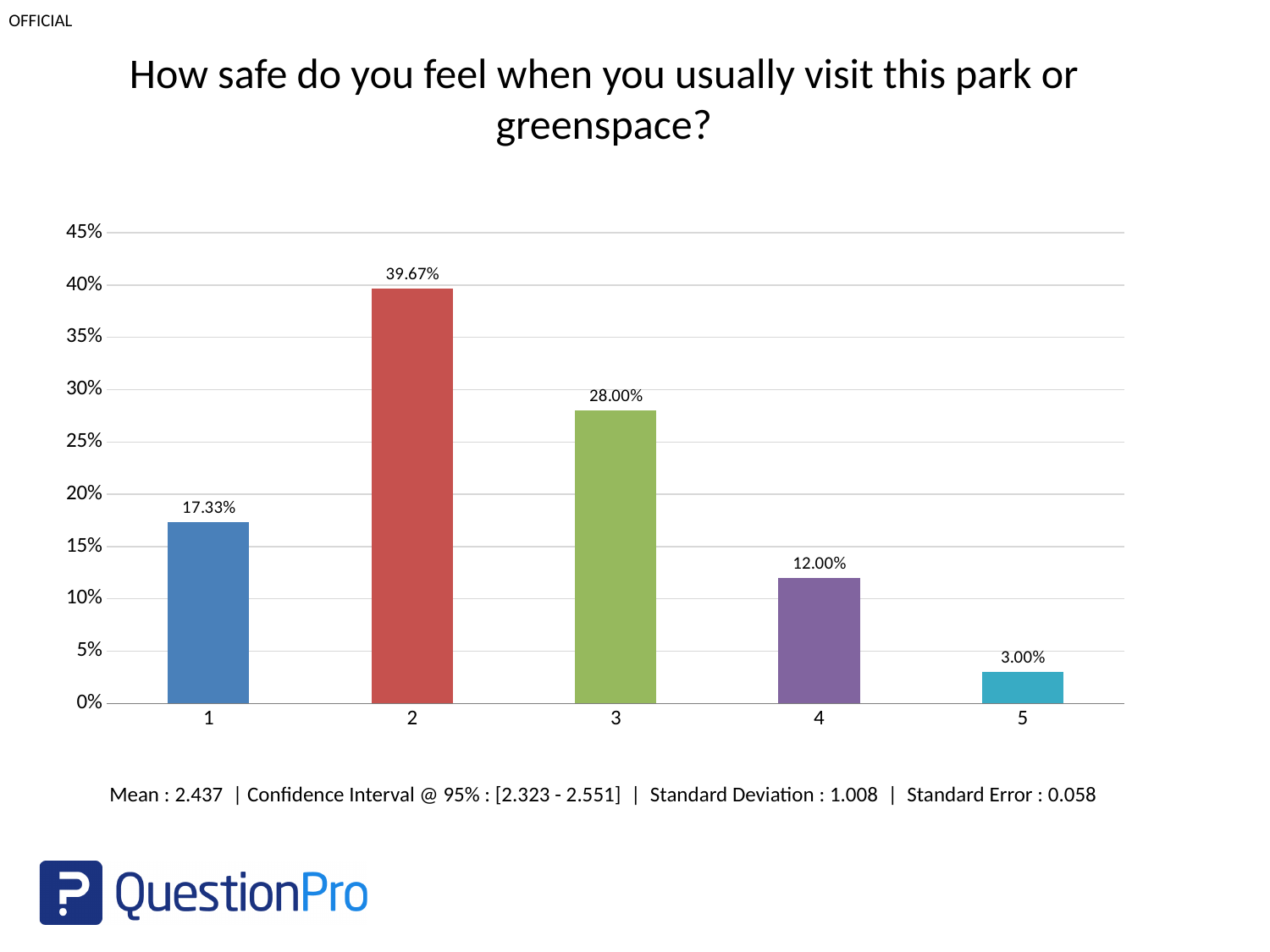
What is the difference between the values for category 1 and category 4? 5.33% Which category has the lowest value? 5 What is the value for category 1? 17.33% Is the value for category 4 greater or less than 15%? less Which category has the highest value? 2 How many categories are shown on the x axis? 5 What kind of chart is shown on the slide? bar chart What is the title of the chart? How safe do you feel when you usually visit this park or greenspace? What is the difference between the values for category 2 and category 3? 11.67% What is the value for category 5? 3.00% Which is larger, the value for category 3 or the value for category 1? 3 What is the value for category 2? 39.67%